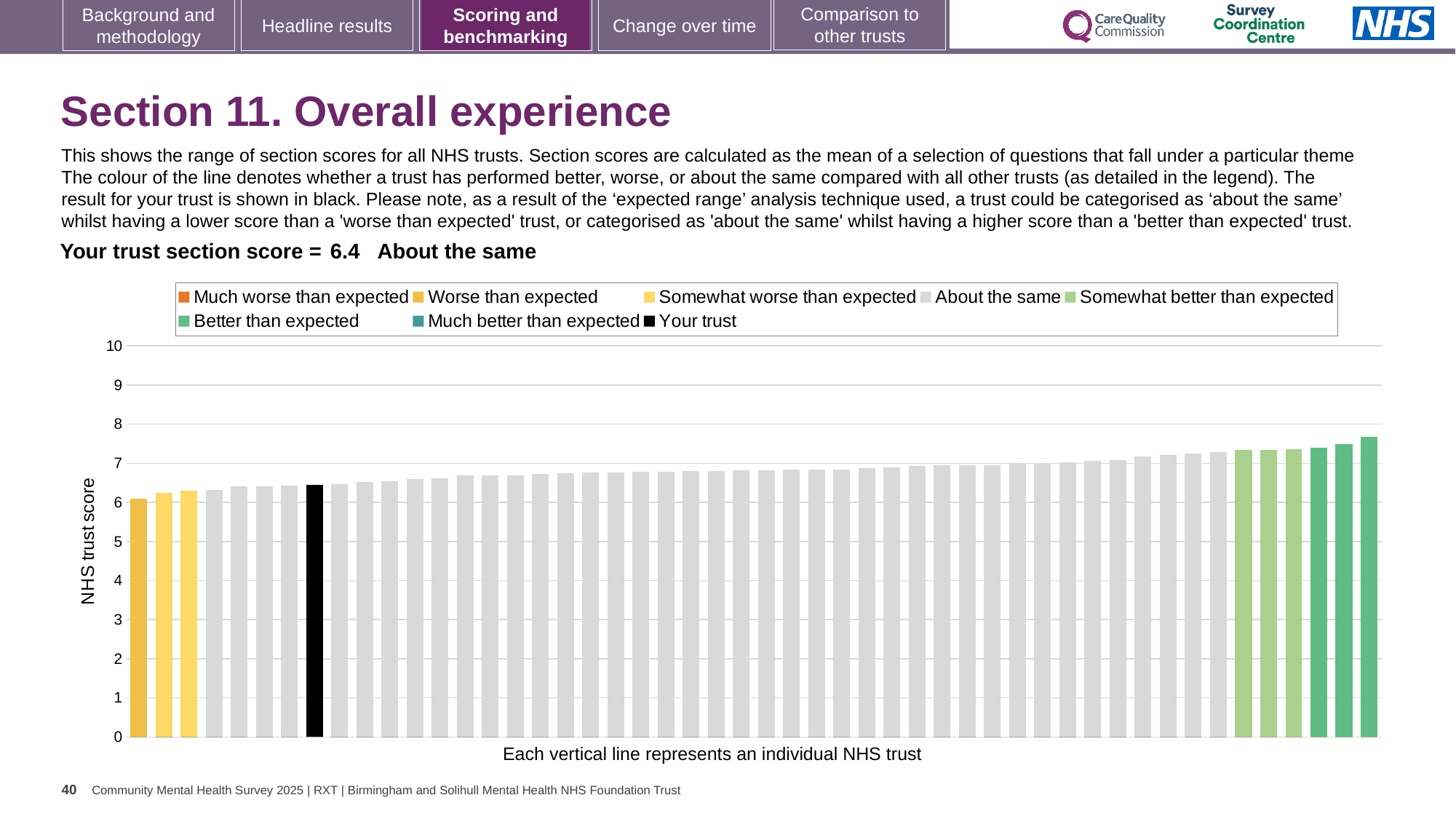
What is the title of the vertical axis? NHS trust score Do the bar values rise or fall from left to right along the x axis? rise How many entries does the chart legend list? 8 Is the value for your trust greater or less than 5? greater Which legend category does the tallest bar belong to? Better than expected Is the value for your trust greater or less than 7? less Which category is your trust's section score placed in? About the same Is the value of the shortest bar greater or less than 7? less What is the section score for your trust? 6.4 What colour is the bar representing your trust? black What kind of chart is shown on the slide? bar chart